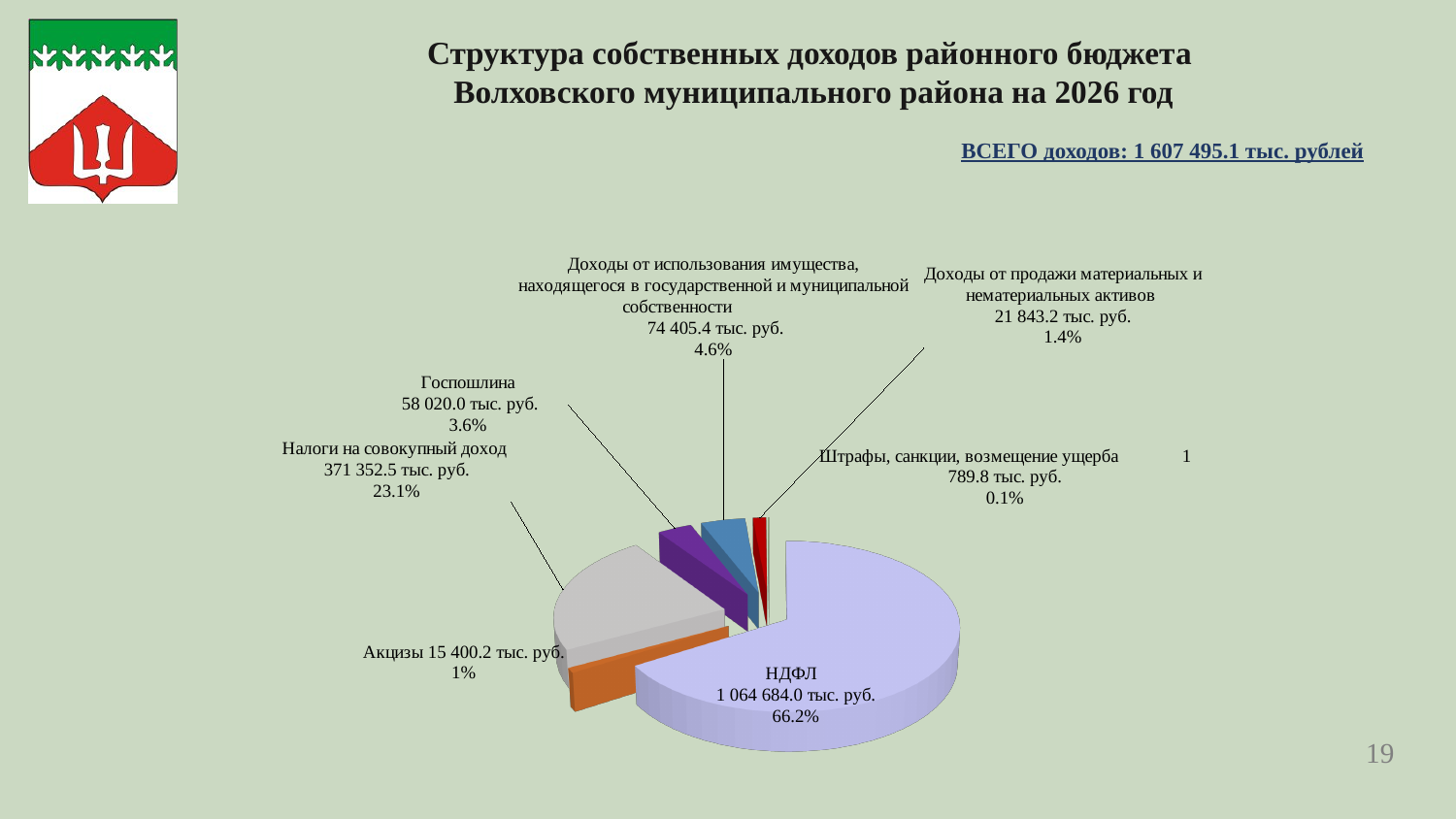
Which category has the largest slice of the pie? НДФЛ Which category has the smallest slice of the pie? Штрафы, санкции, возмещение ущерба What is the difference in percentage points between the share of НДФЛ and the share of Налоги на совокупный доход? 43.1 How many categories are shown in the pie chart? 7 What is the value for Налоги на совокупный доход? 371 352.5 тыс. руб. What is the value for Доходы от продажи материальных и нематериальных активов? 21 843.2 тыс. руб. What share of the pie does Госпошлина represent? 3.6% What share of the pie does НДФЛ represent? 66.2% Which is larger: Госпошлина or Акцизы? Госпошлина What kind of chart is shown on the slide? Pie chart What total income amount is stated on the slide? 1 607 495.1 тыс. рублей What is the value for НДФЛ? 1 064 684.0 тыс. руб.